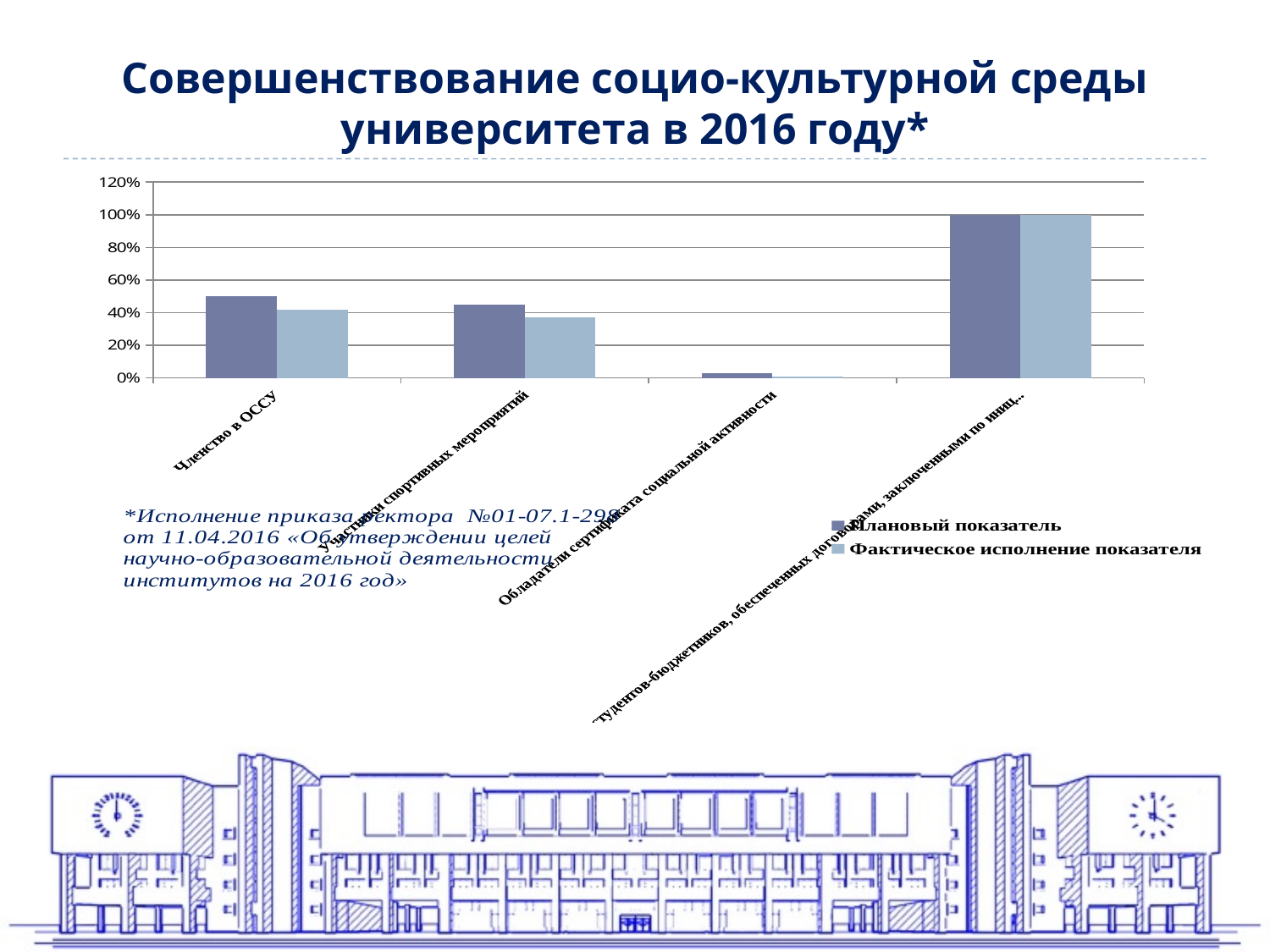
Is the value of Фактическое исполнение показателя for Членство в ОССУ greater or less than 60%? less How many categories are shown on the x axis of the chart? 4 Is the value of Плановый показатель for Членство в ОССУ greater or less than 40%? greater What kind of chart is shown on the slide? Bar chart What is the value of Фактическое исполнение показателя for the rightmost category? 100% For Членство в ОССУ, which is larger: Плановый показатель or Фактическое исполнение показателя? Плановый показатель Is the value of Плановый показатель for Обладатели сертификата социальной активности greater or less than 20%? less What are the two series named in the legend? Плановый показатель; Фактическое исполнение показателя Which category has the lowest value for Плановый показатель? Обладатели сертификата социальной активности What is the value of Плановый показатель for the rightmost category? 100% Which category has the highest value for Фактическое исполнение показателя? The rightmost category (Студентов-бюджетников, обеспеченных договорами...) How many series does the legend list? 2